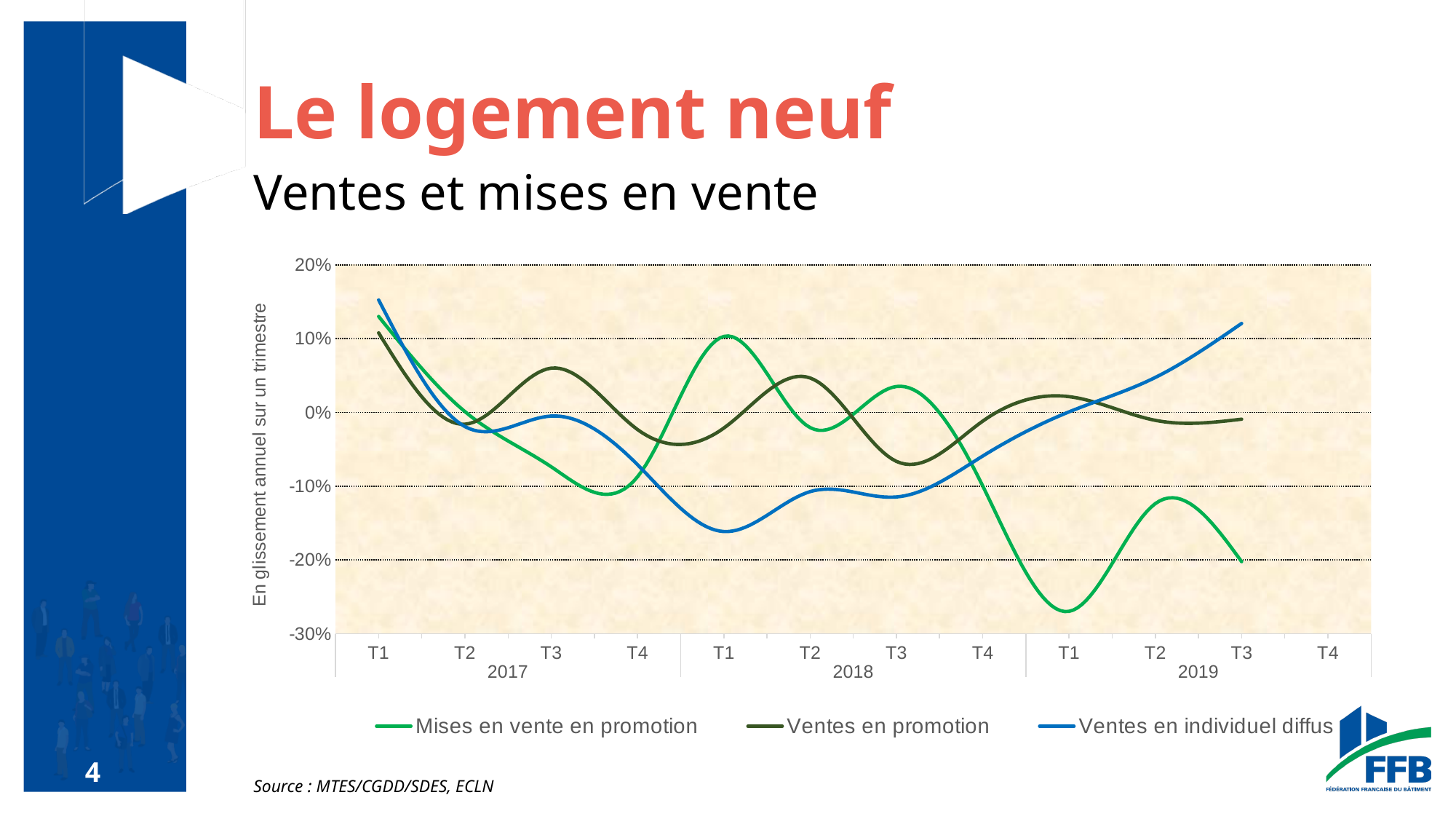
At T1 2019, which series has the higher value: Ventes en individuel diffus or Mises en vente en promotion? Ventes en individuel diffus Which series is drawn in blue? Ventes en individuel diffus Is the value for Mises en vente en promotion at T1 2019 greater or less than -20%? less What kind of chart is shown on the slide? Line chart Which series reaches the lowest point on the chart? Mises en vente en promotion How many series does the legend list? 3 What is the label of the vertical axis? En glissement annuel sur un trimestre Is the value for Ventes en promotion at T3 2017 greater or less than 0%? greater At T1 2018, which series has the higher value: Mises en vente en promotion or Ventes en individuel diffus? Mises en vente en promotion Does the Ventes en individuel diffus series rise or fall between T1 2018 and T3 2019? Rise Is the value for Ventes en individuel diffus at T1 2018 greater or less than -10%? less